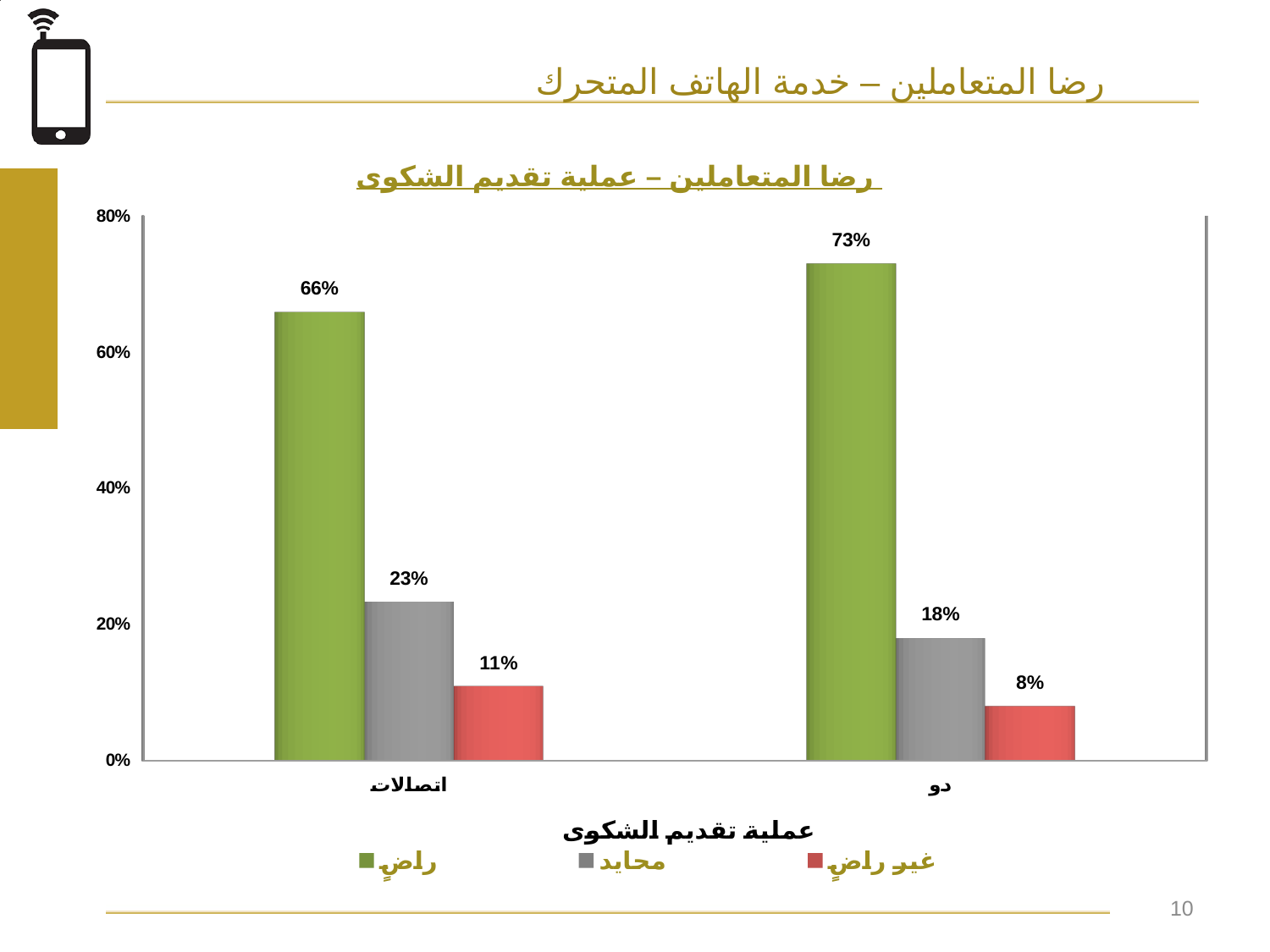
What is the value for غير راضٍ (dissatisfied) for دو? 8% Which series has the lowest value for اتصالات? غير راضٍ What colour represents the راضٍ (satisfied) series? Green What is the difference between the محايد (neutral) values for اتصالات and دو? 5% How many categories are shown on the x axis? 2 What is the value for راضٍ (satisfied) for دو? 73% What is the value for راضٍ (satisfied) for اتصالات? 66% How many series does the legend list? 3 What is the difference between the راضٍ (satisfied) values for دو and اتصالات? 7% What is the value for محايد (neutral) for اتصالات? 23% What kind of chart is shown on the slide? Bar chart Which category has the higher value for راضٍ (satisfied), اتصالات or دو? دو